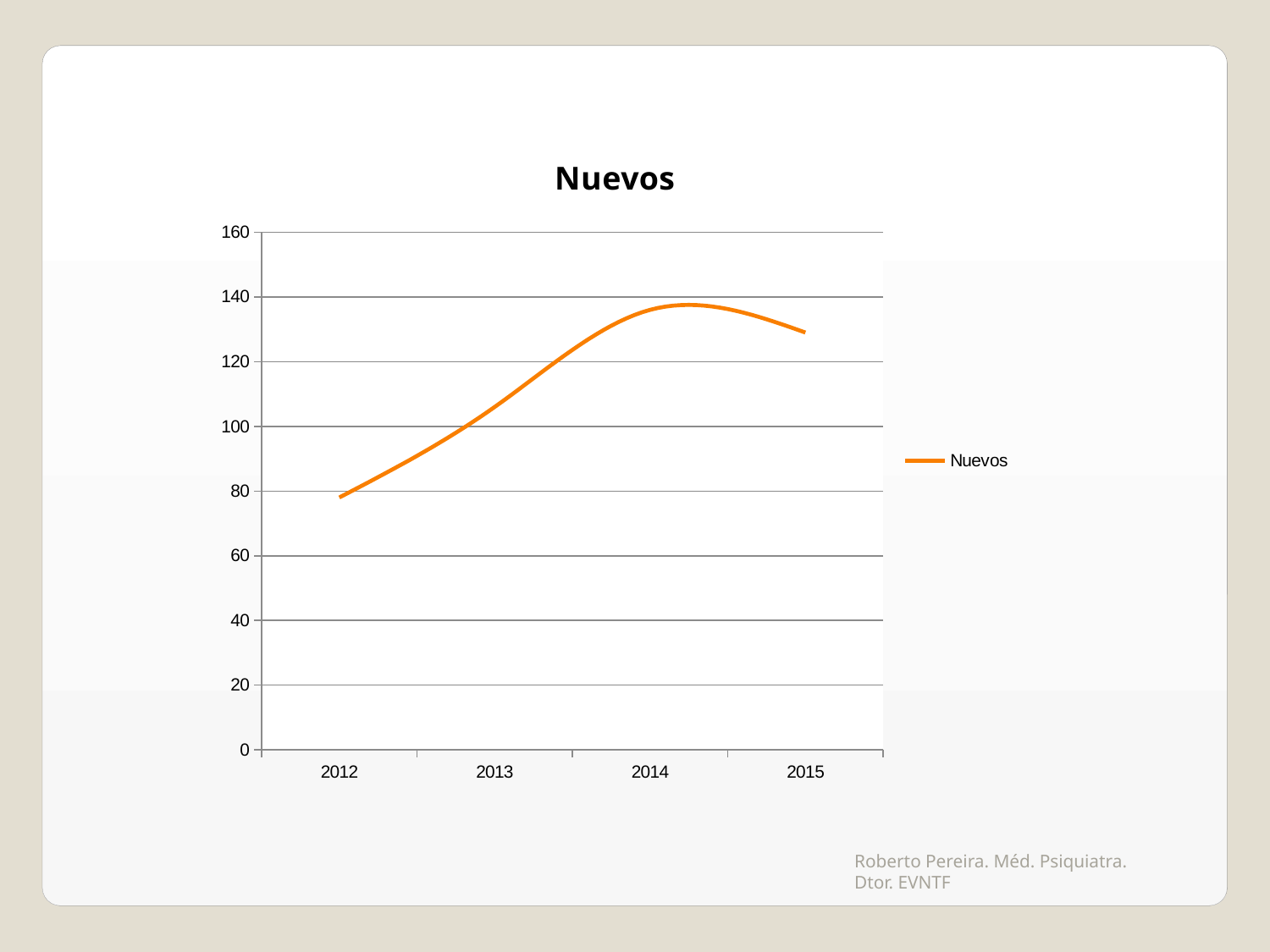
Does the value for Nuevos rise or fall from 2014 to 2015? fall Is the value for 2012 greater or less than 100? less Which year has the lowest value for Nuevos? 2012 Does the value for Nuevos rise or fall from 2012 to 2014? rise Is the value for 2015 greater or less than 140? less Is the value for 2014 greater or less than 120? greater How many series does the legend list? 1 Which year has the highest value for Nuevos? 2014 Which is larger, the value for 2014 or the value for 2015? 2014 What is the title of the chart? Nuevos What kind of chart is shown on the slide? line chart How many years are shown on the x axis? 4